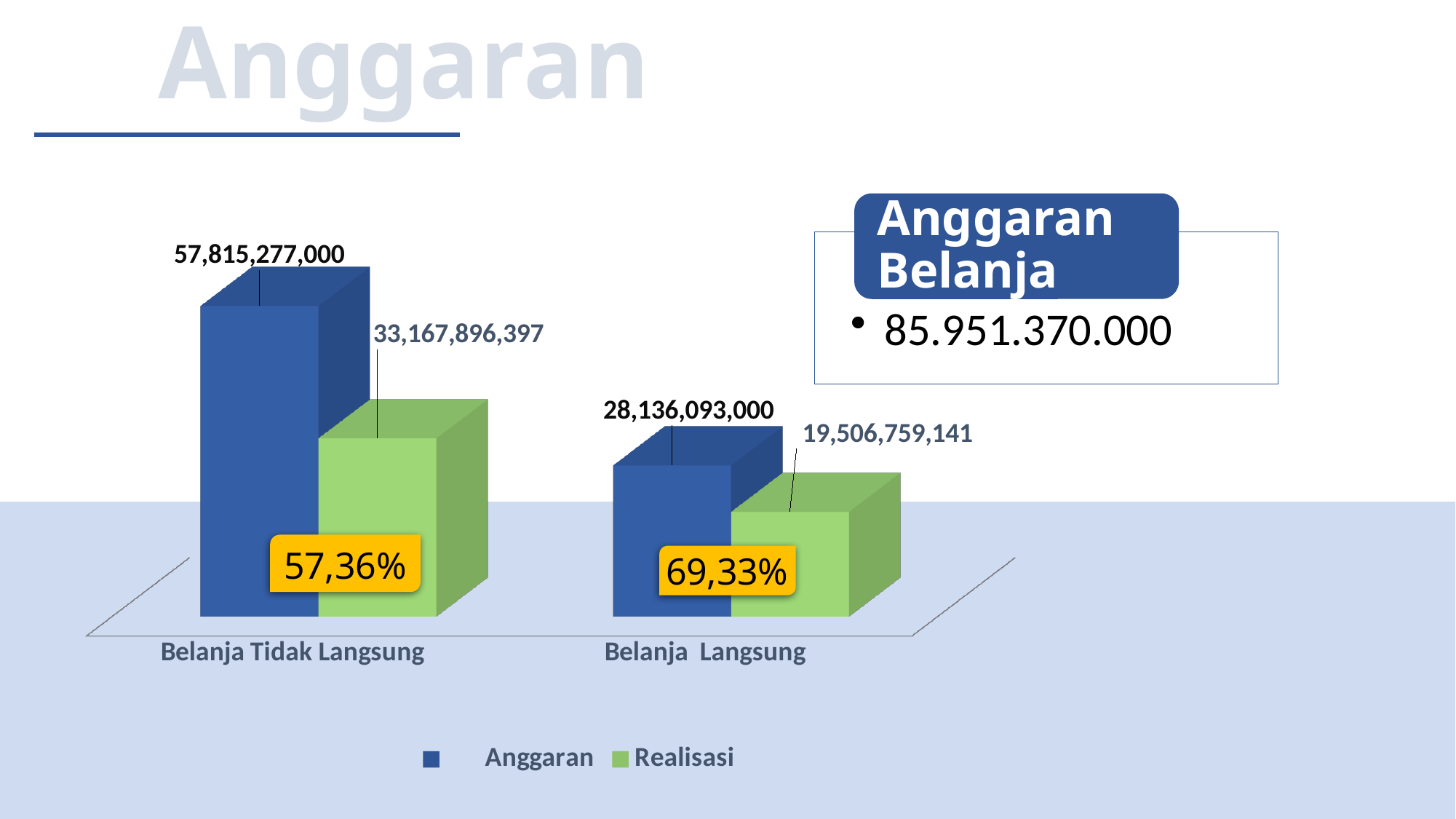
What is the Anggaran value for Belanja Langsung? 28,136,093,000 What percentage label is shown for Belanja Tidak Langsung? 57,36% What is the difference between the Anggaran and Realisasi values for Belanja Langsung? 8,629,333,859 Which category has the highest Anggaran value? Belanja Tidak Langsung What type of chart is shown on the slide? bar chart What percentage label is shown for Belanja Langsung? 69,33% How many categories are shown on the x axis? 2 How many series does the legend list? 2 What is the Anggaran value for Belanja Tidak Langsung? 57,815,277,000 What is the Realisasi value for Belanja Tidak Langsung? 33,167,896,397 What is the Realisasi value for Belanja Langsung? 19,506,759,141 Which is larger for Belanja Tidak Langsung, Anggaran or Realisasi? Anggaran